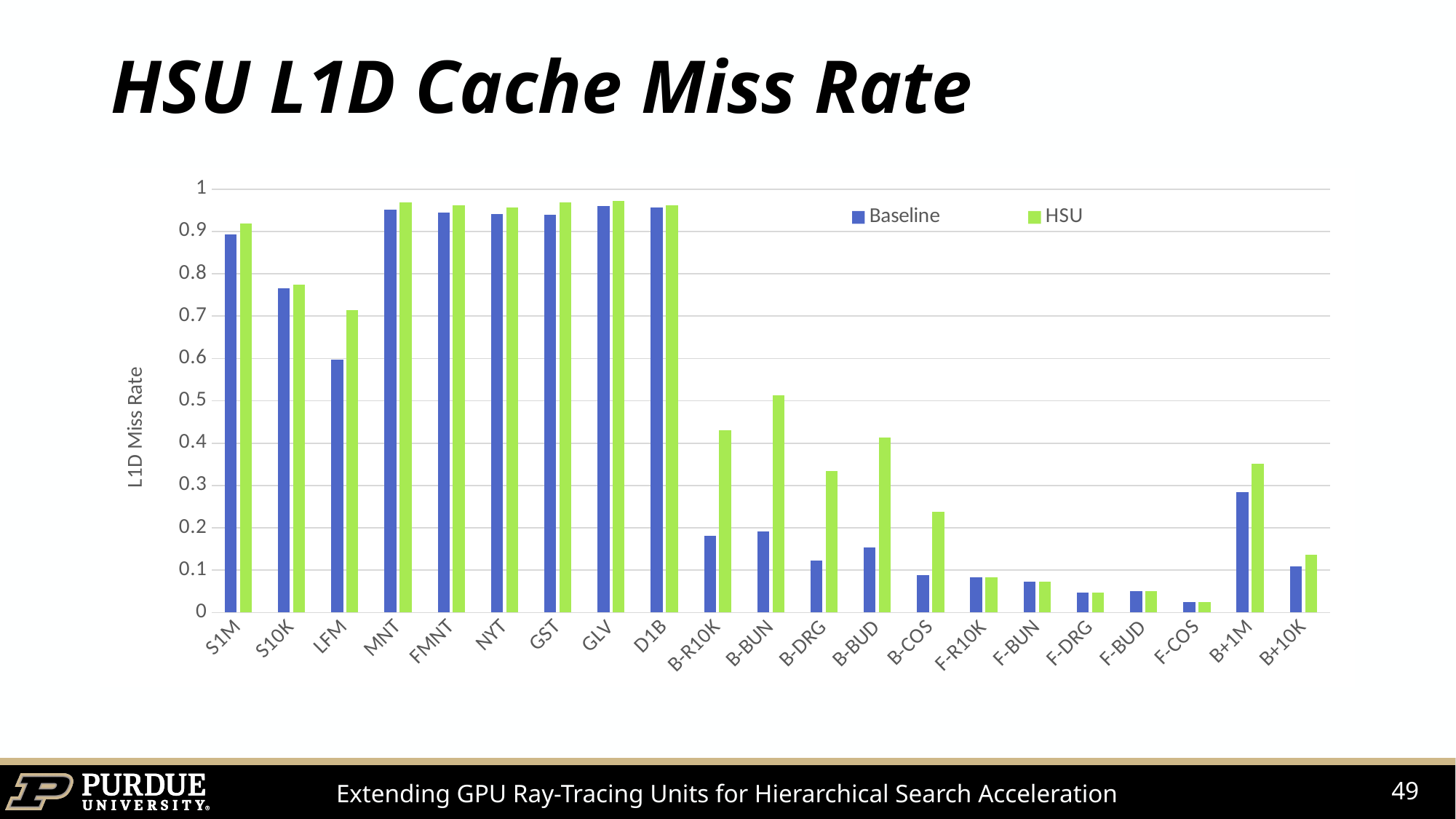
Which category has the lowest HSU L1D miss rate? F-COS Which category has the lowest Baseline L1D miss rate? F-COS Is the HSU value for B-R10K greater or less than 0.4? greater How many series does the legend list? 2 Is the Baseline value for B+1M greater or less than 0.3? less Is the HSU value for B-DRG greater or less than 0.3? greater What is the label of the y axis? L1D Miss Rate What kind of chart is shown on the slide? bar chart For B-BUN, which series has the larger value, Baseline or HSU? HSU How many categories are shown on the x axis? 21 For LFM, which series has the larger value, Baseline or HSU? HSU